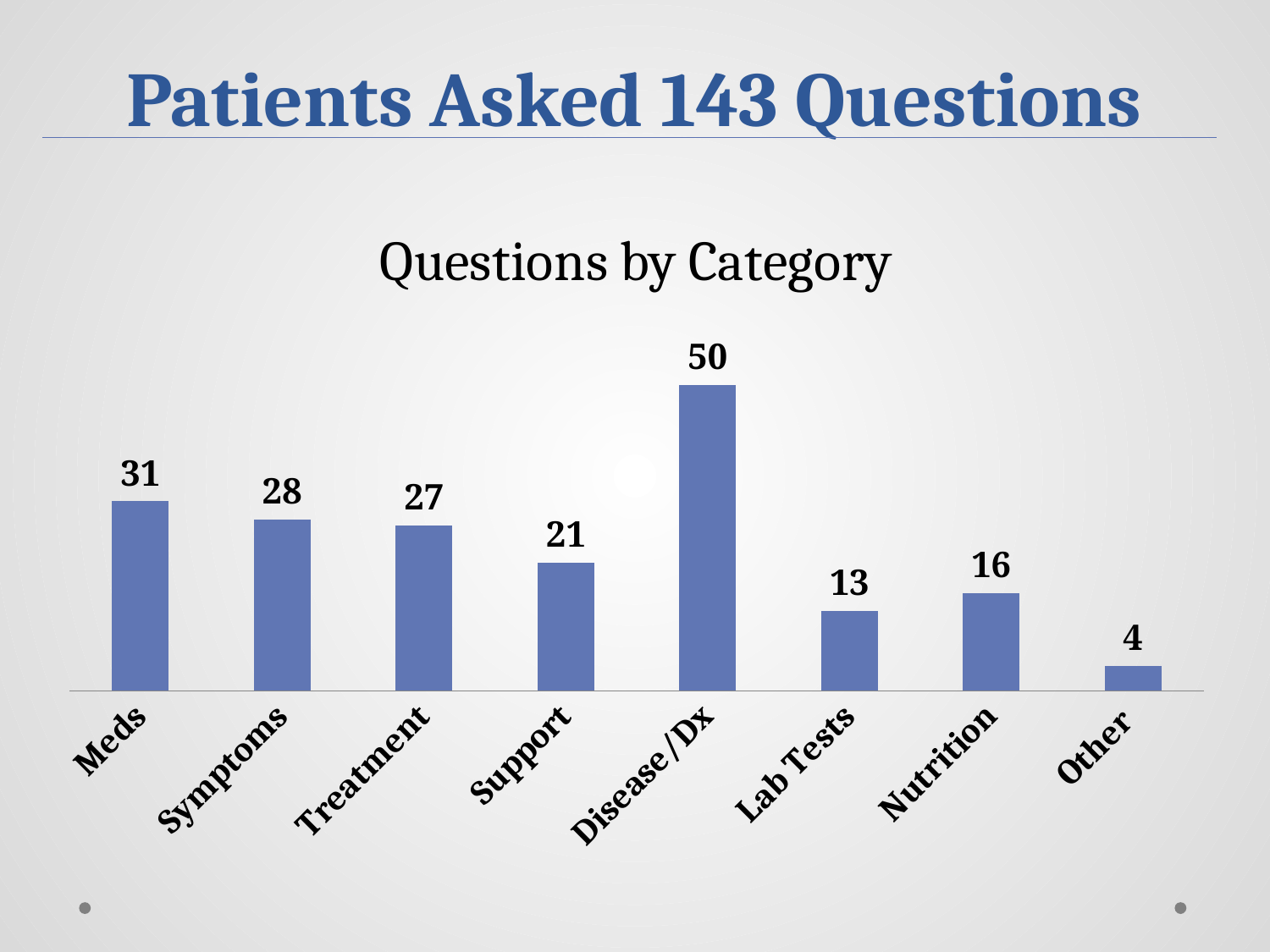
Which category has the lowest value? Other How many categories are shown on the x axis? 8 What is the value for Nutrition? 16 What is the value for Meds? 31 Which is larger, the value for Treatment or the value for Nutrition? Treatment Which category has the highest value? Disease/Dx What is the value for Lab Tests? 13 What is the difference between the values for Symptoms and Support? 7 What is the title of the chart? Questions by Category What is the value for Disease/Dx? 50 What is the difference between the values for Disease/Dx and Meds? 19 What kind of chart is shown on the slide? Bar chart